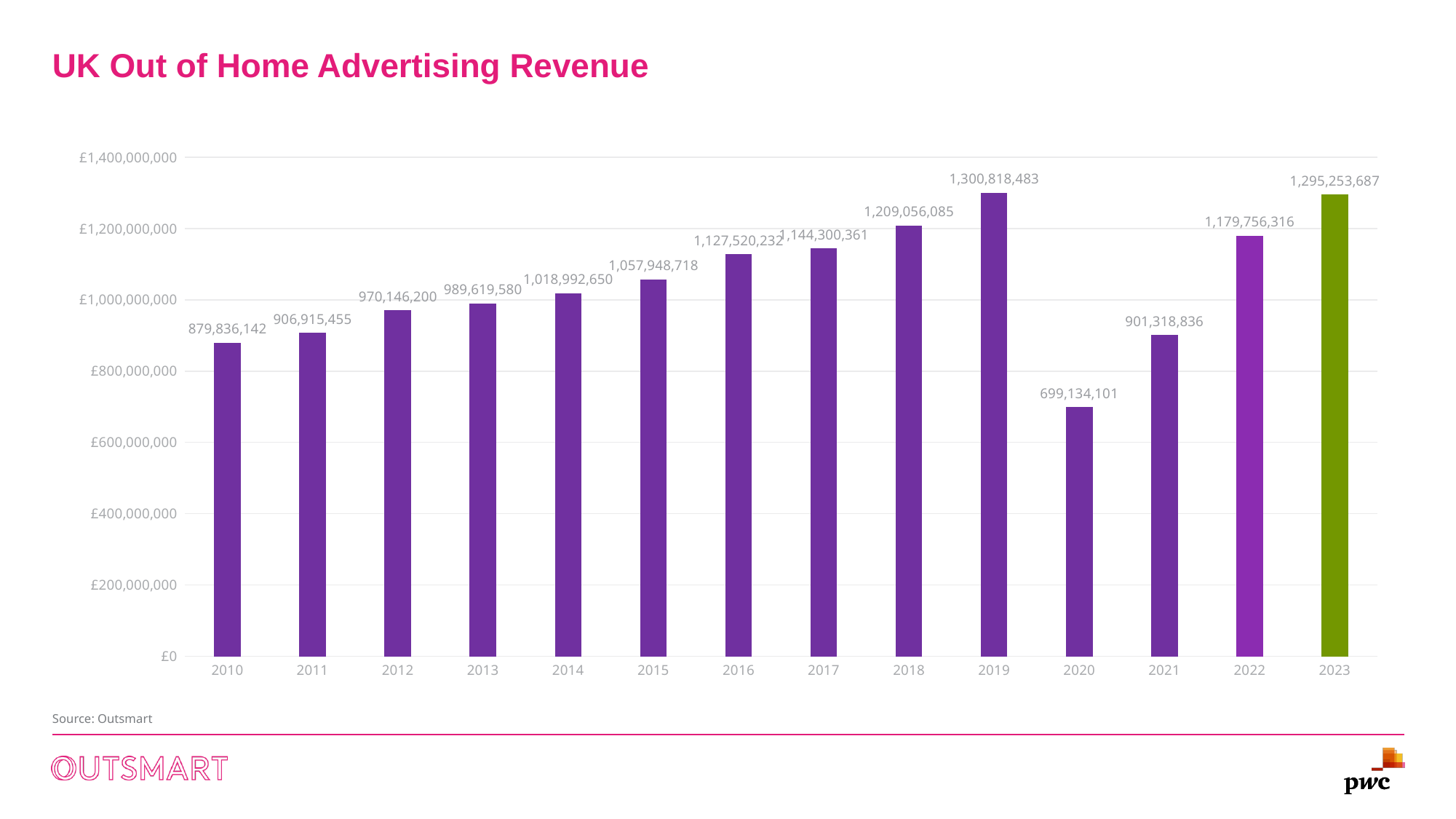
How many years are shown on the chart? 14 Do the revenue values rise or fall from 2010 to 2019? rise What is the revenue value shown for 2023? 1,295,253,687 What is the revenue value shown for 2020? 699,134,101 Which year has the highest revenue? 2019 By how much did revenue increase from 2022 to 2023? 115,497,371 What is the difference between the 2019 and 2020 revenue values? 601,684,382 What kind of chart is shown on the slide? bar chart Is the value for 2020 greater or less than £800,000,000? less Which year has the lowest revenue? 2020 What is the UK Out of Home advertising revenue for 2019? 1,300,818,483 Which year has the larger revenue, 2018 or 2022? 2018